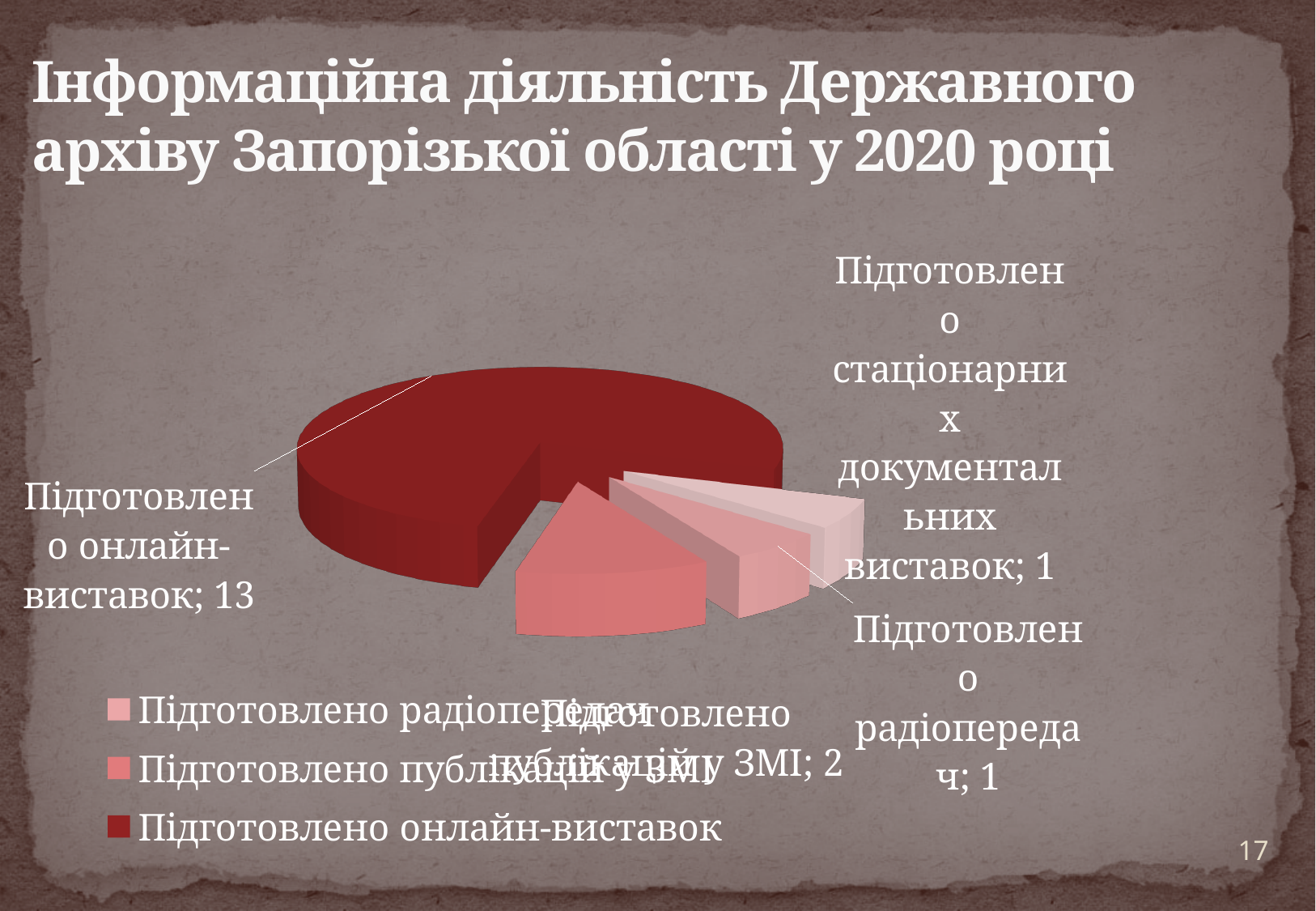
What kind of chart is shown on the slide? Pie chart How many slices does the pie chart have? 4 What is the value for Підготовлено стаціонарних документальних виставок? 1 What is the total of all values shown in the pie chart? 17 What is the title of the slide? Інформаційна діяльність Державного архіву Запорізької області у 2020 році How many entries does the legend list? 3 How many online exhibitions (Підготовлено онлайн-виставок) were prepared according to the chart? 13 What is the value for Підготовлено публікацій у ЗМІ? 2 What is the value for Підготовлено радіопередач? 1 Which category has the largest slice of the pie? Підготовлено онлайн-виставок What is the difference between the number of online exhibitions and the number of publications in the media? 11 Which is larger: Підготовлено публікацій у ЗМІ or Підготовлено радіопередач? Підготовлено публікацій у ЗМІ